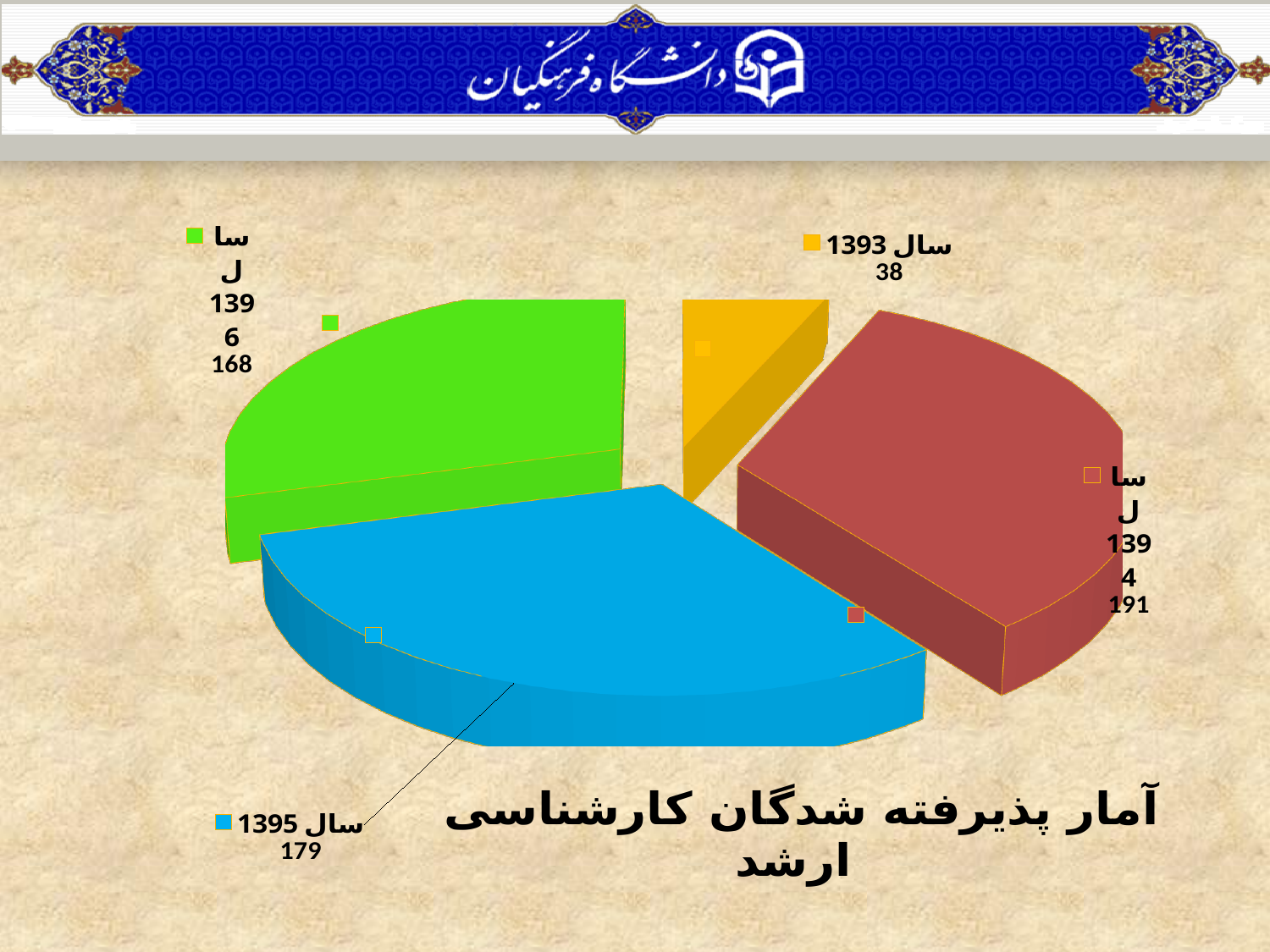
What is the value for سال 1395 in the pie chart? 179 What is the total of all four slices in the pie chart? 576 What is the value for سال 1394 in the pie chart? 191 Which is larger, the value for سال 1395 or the value for سال 1396? سال 1395 What is the value for سال 1396 in the pie chart? 168 What is the value for سال 1393 in the pie chart? 38 How many slices does the pie chart have? 4 What is the difference between the values for سال 1394 and سال 1395? 12 What kind of chart is shown on the slide? Pie chart Which year has the largest slice in the pie chart? سال 1394 Which year has the smallest slice in the pie chart? سال 1393 What is the difference between the values for سال 1396 and سال 1393? 130